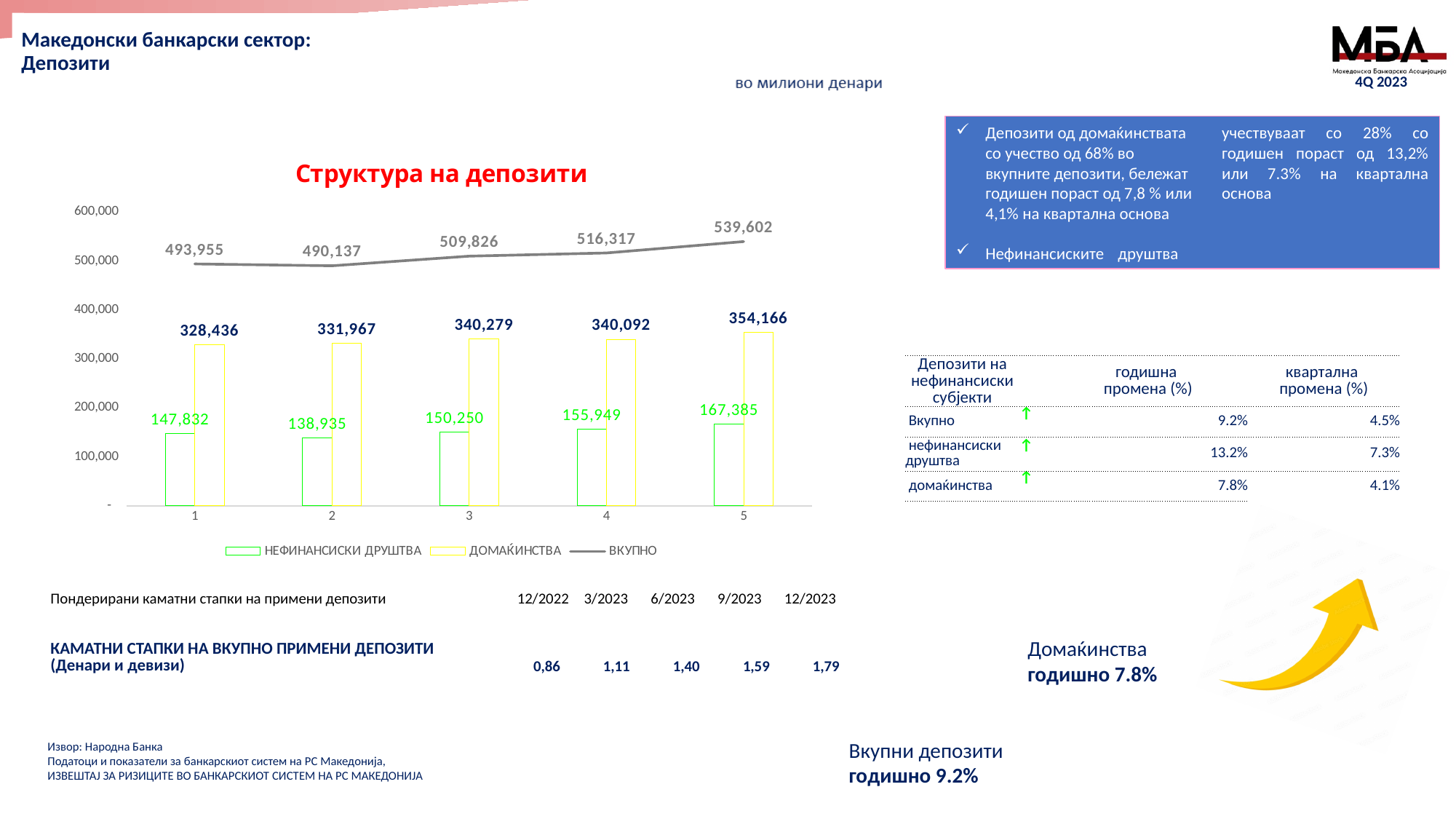
What is the value of ДОМАЌИНСТВА at category 3? 340,279 What is the difference between ВКУПНО at category 5 and at category 4? 23,285 What is the title of the chart? Структура на депозити What is the difference between ДОМАЌИНСТВА and НЕФИНАНСИСКИ ДРУШТВА at category 5? 186,781 How many series does the legend list? 3 How many categories are shown on the x axis? 5 Does the ДОМАЌИНСТВА series rise or fall from category 1 to category 5? rise Which is larger at category 1: ДОМАЌИНСТВА or НЕФИНАНСИСКИ ДРУШТВА? ДОМАЌИНСТВА What is the value of ВКУПНО at category 5? 539,602 What is the value of НЕФИНАНСИСКИ ДРУШТВА at category 2? 138,935 At which category is ВКУПНО lowest? 2 At which category is НЕФИНАНСИСКИ ДРУШТВА highest? 5